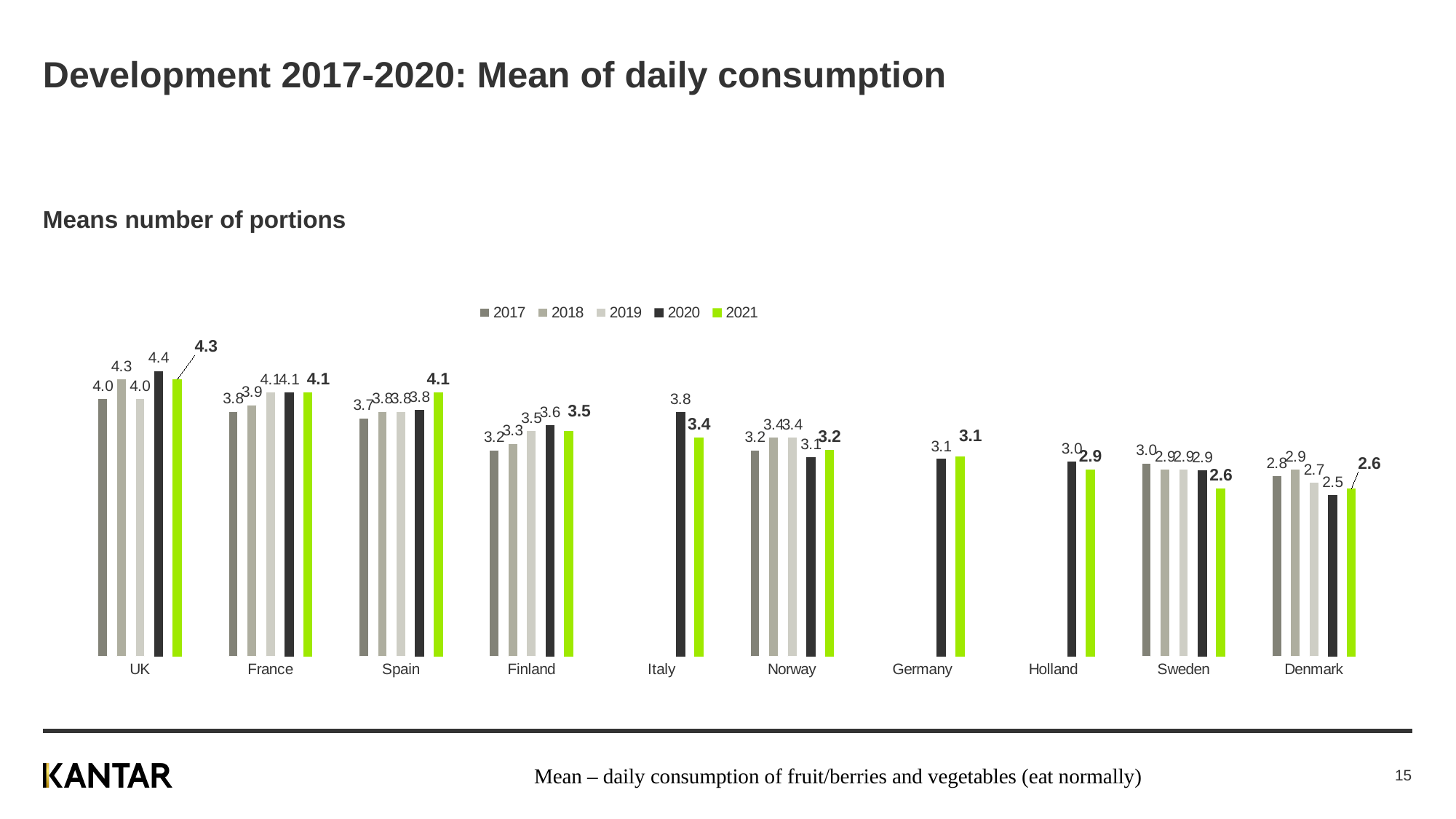
What is the 2020 value for Italy? 3.8 What is the 2021 value for the UK? 4.3 Which is larger, the 2021 value for Spain or the 2021 value for Finland? Spain Which country has the lowest 2020 value? Denmark What is the difference between the 2020 and 2021 values for Italy? 0.4 Do the 2021 values generally rise or fall from UK to Denmark along the x axis? Fall Which country has the highest 2021 value? UK What kind of chart is shown on the slide? Bar chart How many series does the legend list? 5 What is the 2021 value for Denmark? 2.6 What is the 2017 value for Finland? 3.2 How many countries are shown on the x axis? 10